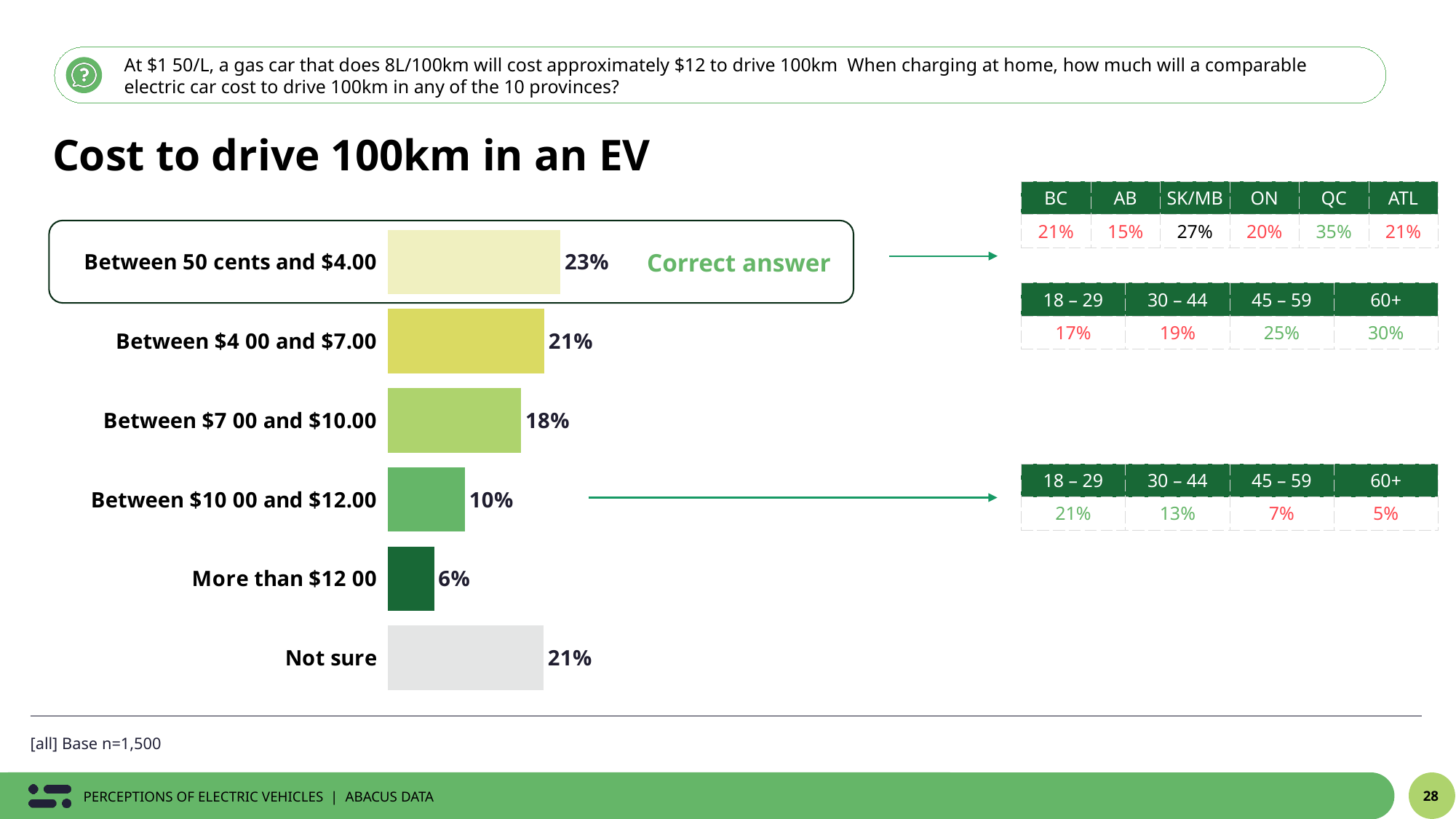
Which response category has the lowest percentage? More than $12.00 What is the difference between the values for "Between 50 cents and $4.00" and "More than $12.00"? 17% What is the value for "Between $10.00 and $12.00"? 10% How many response categories are shown in the bar chart? 6 What is the value shown for "More than $12.00"? 6% Which response category has the highest percentage? Between 50 cents and $4.00 What percentage of respondents answered "Between 50 cents and $4.00"? 23% What type of chart is used on this slide? Bar chart What percentage of respondents said "Not sure"? 21% What is the difference between the values for "Between $7.00 and $10.00" and "Between $10.00 and $12.00"? 8% Which is larger: the value for "Between $4.00 and $7.00" or the value for "Between $7.00 and $10.00"? Between $4.00 and $7.00 Which response category is marked as the "Correct answer"? Between 50 cents and $4.00